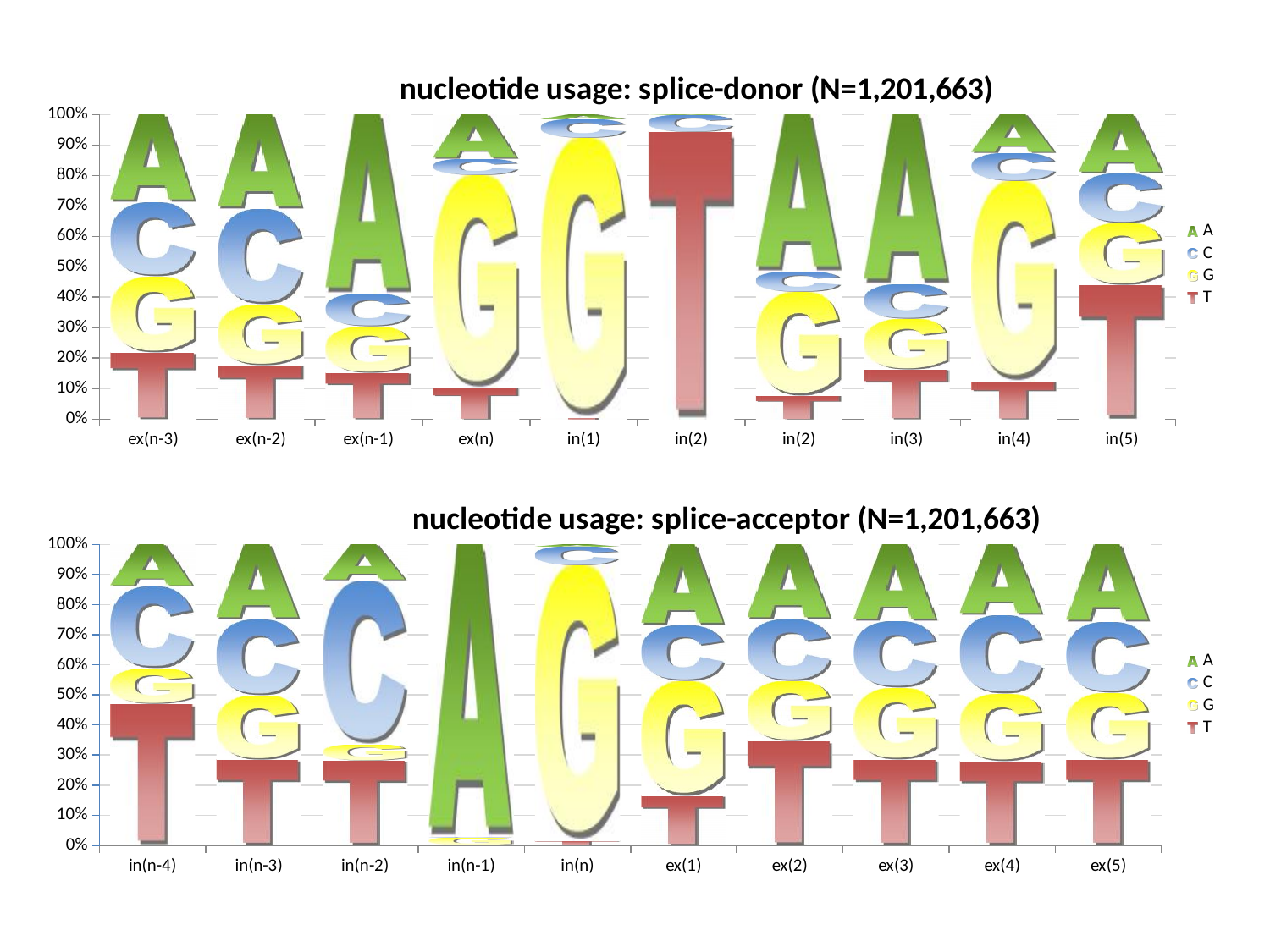
In the bottom chart (splice-acceptor), is the share of T at position ex(1) greater or less than 20%? less How many positions (categories) are shown on the x axis of the bottom chart titled 'nucleotide usage: splice-acceptor'? 10 In the bottom chart (splice-acceptor), which nucleotide has the largest share at position in(n-1)? A What is the title of the bottom chart? nucleotide usage: splice-acceptor (N=1,201,663) What kind of chart is the top chart titled 'nucleotide usage: splice-donor'? stacked bar chart In the top chart (splice-donor), is the share of G at position in(1) greater or less than 80%? greater How many series does the legend of the top chart list? 4 In the top chart (splice-donor), at position ex(n-1), which is larger: the share of A or the share of C? A In the top chart (splice-donor), is the share of T at position ex(n-3) greater or less than 30%? less